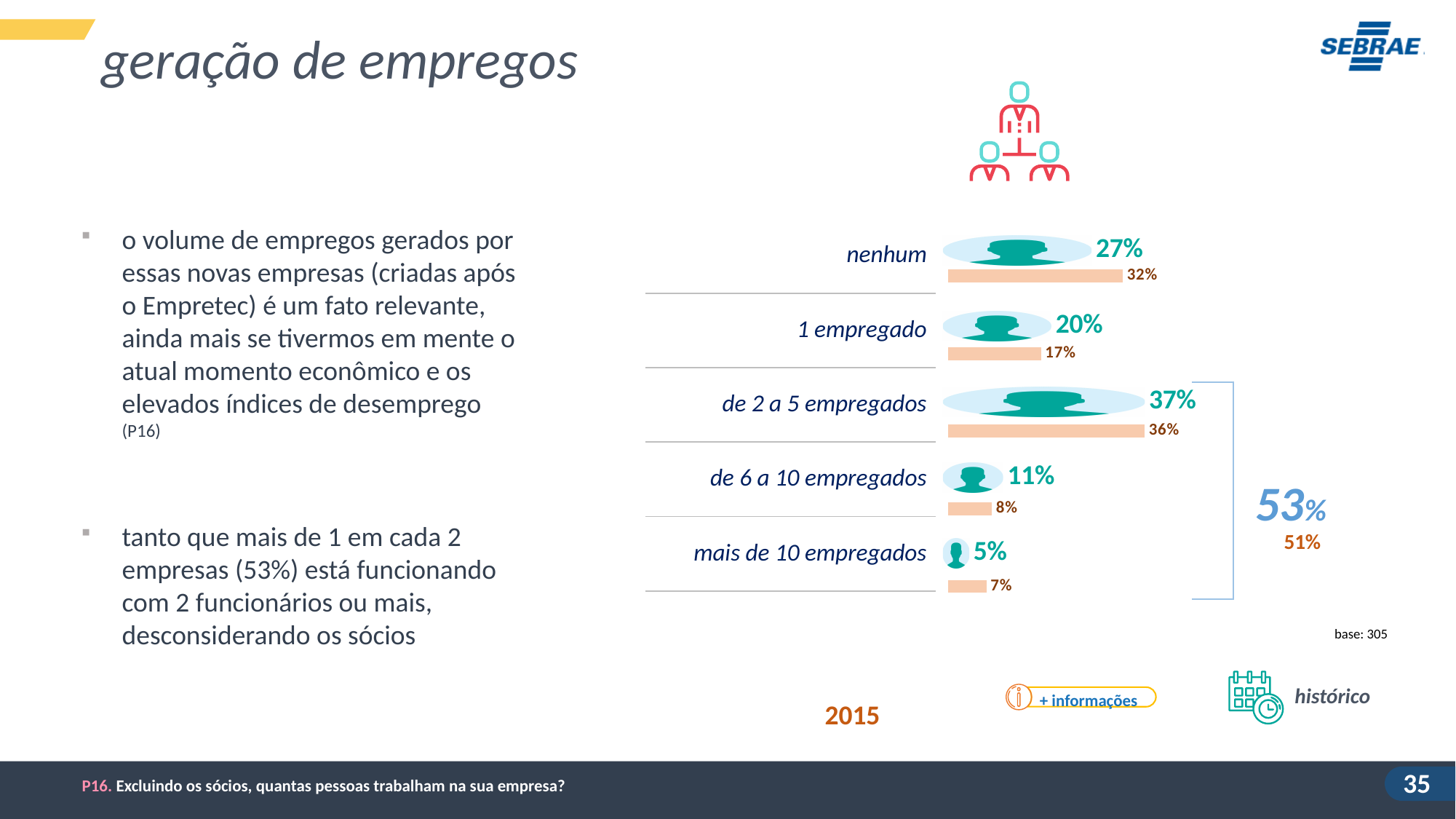
What is the current (teal) value for 'de 2 a 5 empregados'? 37% What is the 2015 (orange bar) value for 'de 6 a 10 empregados'? 8% What is the difference between the current value and the 2015 value for 'nenhum'? 5% What is the current (teal) value for 'mais de 10 empregados'? 5% Which year do the orange bars represent? 2015 Which category has the highest current (teal) value? de 2 a 5 empregados What is the base (number of respondents) shown for the chart? 305 What is the 2015 (orange bar) value for 'nenhum'? 32% Which category has the lowest 2015 (orange bar) value? mais de 10 empregados How many employee-count categories are shown in the chart? 5 What combined share is shown by the bracket for companies with 2 or more employees in the current survey? 53% Which is larger for '1 empregado': the current value or the 2015 value? the current value (20%)